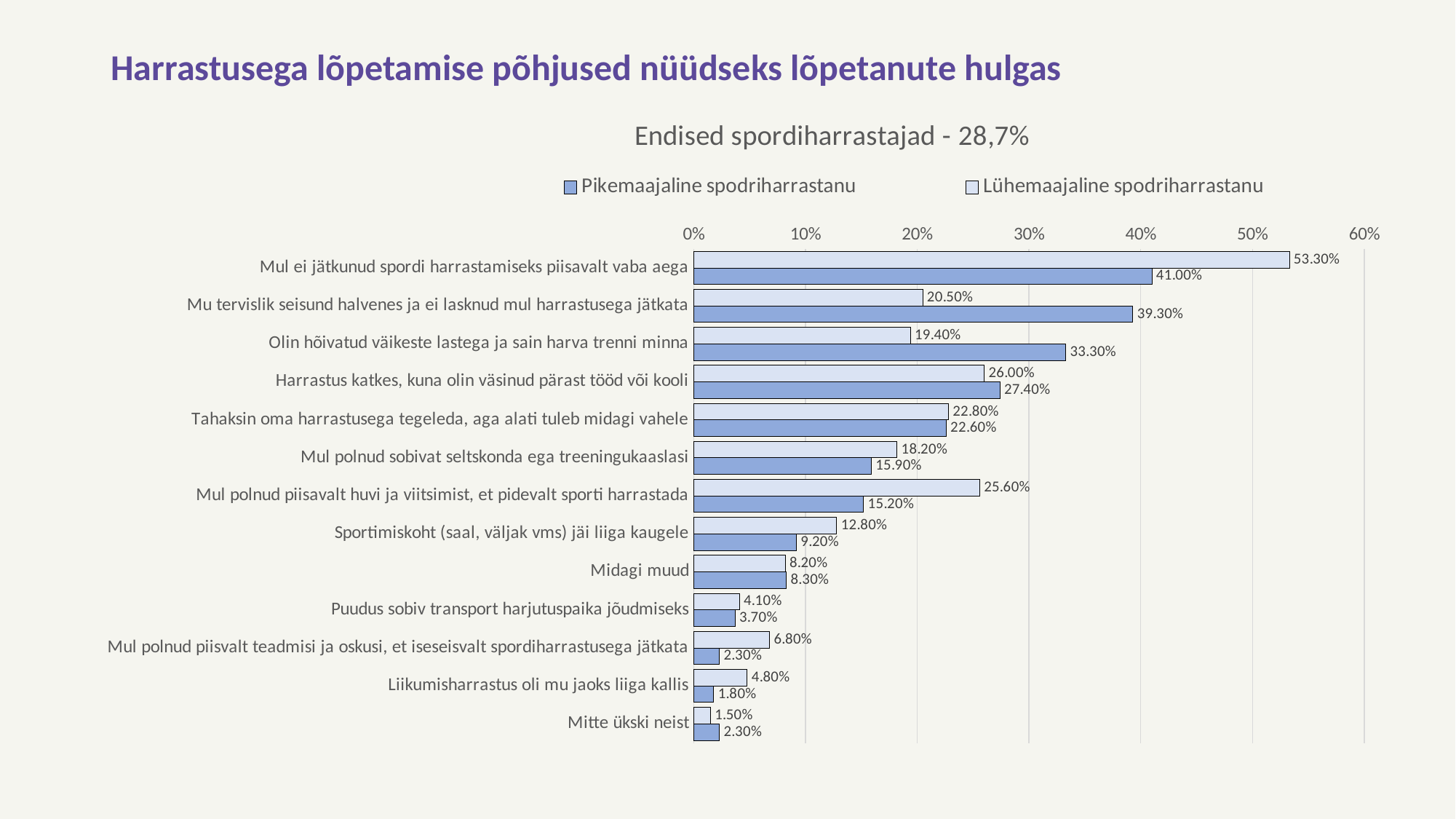
How many categories (reasons) are shown on the chart? 13 Which category has the lowest value for 'Pikemaajaline spodriharrastanu'? Liikumisharrastus oli mu jaoks liiga kallis What is the difference between the 'Lühemaajaline spodriharrastanu' and 'Pikemaajaline spodriharrastanu' values for 'Mul polnud piisavalt huvi ja viitsimist, et pidevalt sporti harrastada'? 10.40% What is the value for 'Lühemaajaline spodriharrastanu' for 'Mu tervislik seisund halvenes ja ei lasknud mul harrastusega jätkata'? 20.50% How many series does the legend list? 2 Is the 'Lühemaajaline spodriharrastanu' value for 'Mul ei jätkunud spordi harrastamiseks piisavalt vaba aega' greater or less than 50%? greater Which category has the highest value for 'Lühemaajaline spodriharrastanu'? Mul ei jätkunud spordi harrastamiseks piisavalt vaba aega What is the title of the chart? Endised spordiharrastajad - 28,7% What type of chart is shown on the slide? bar chart For 'Mu tervislik seisund halvenes ja ei lasknud mul harrastusega jätkata', which series has the larger value? Pikemaajaline spodriharrastanu What is the value for 'Pikemaajaline spodriharrastanu' for 'Olin hõivatud väikeste lastega ja sain harva trenni minna'? 33.30% What is the value for 'Pikemaajaline spodriharrastanu' for 'Mul ei jätkunud spordi harrastamiseks piisavalt vaba aega'? 41.00%